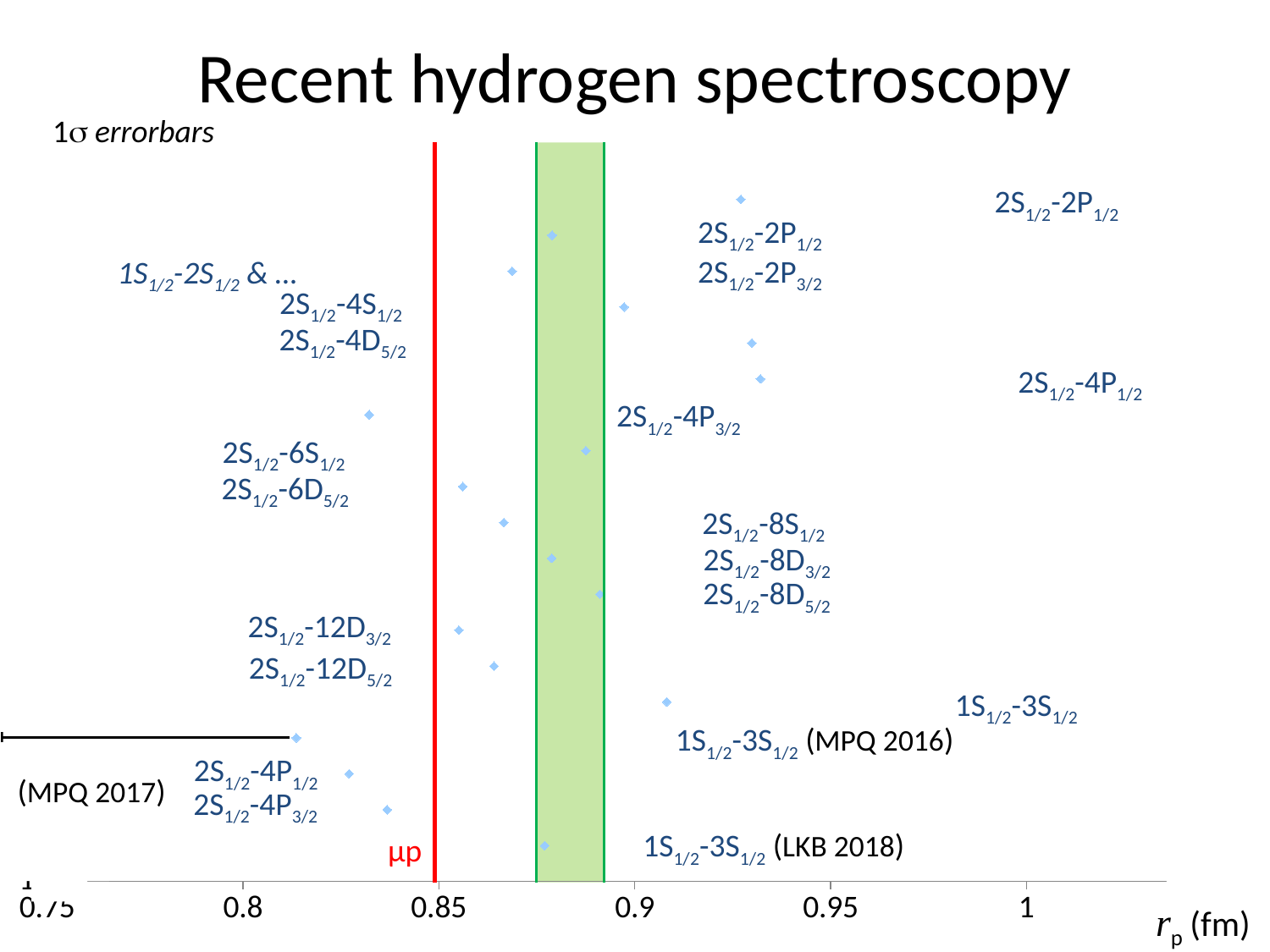
What is the largest tick value shown on the x axis? 1 What quantity is plotted on the x axis? r_p (fm) Is the green shaded band located at values greater or less than 0.85? greater What kind of chart is shown on the slide? scatter chart What is the title of the chart? Recent hydrogen spectroscopy What is the smallest tick value shown on the x axis? 0.75 What label is attached to the red vertical line? μp Is the value for the 1S1/2-3S1/2 (LKB 2018) point greater or less than 0.85? greater What size of error bars does the slide say are shown? 1σ errorbars Is the value for the 1S1/2-3S1/2 (MPQ 2016) point greater or less than 0.85? greater